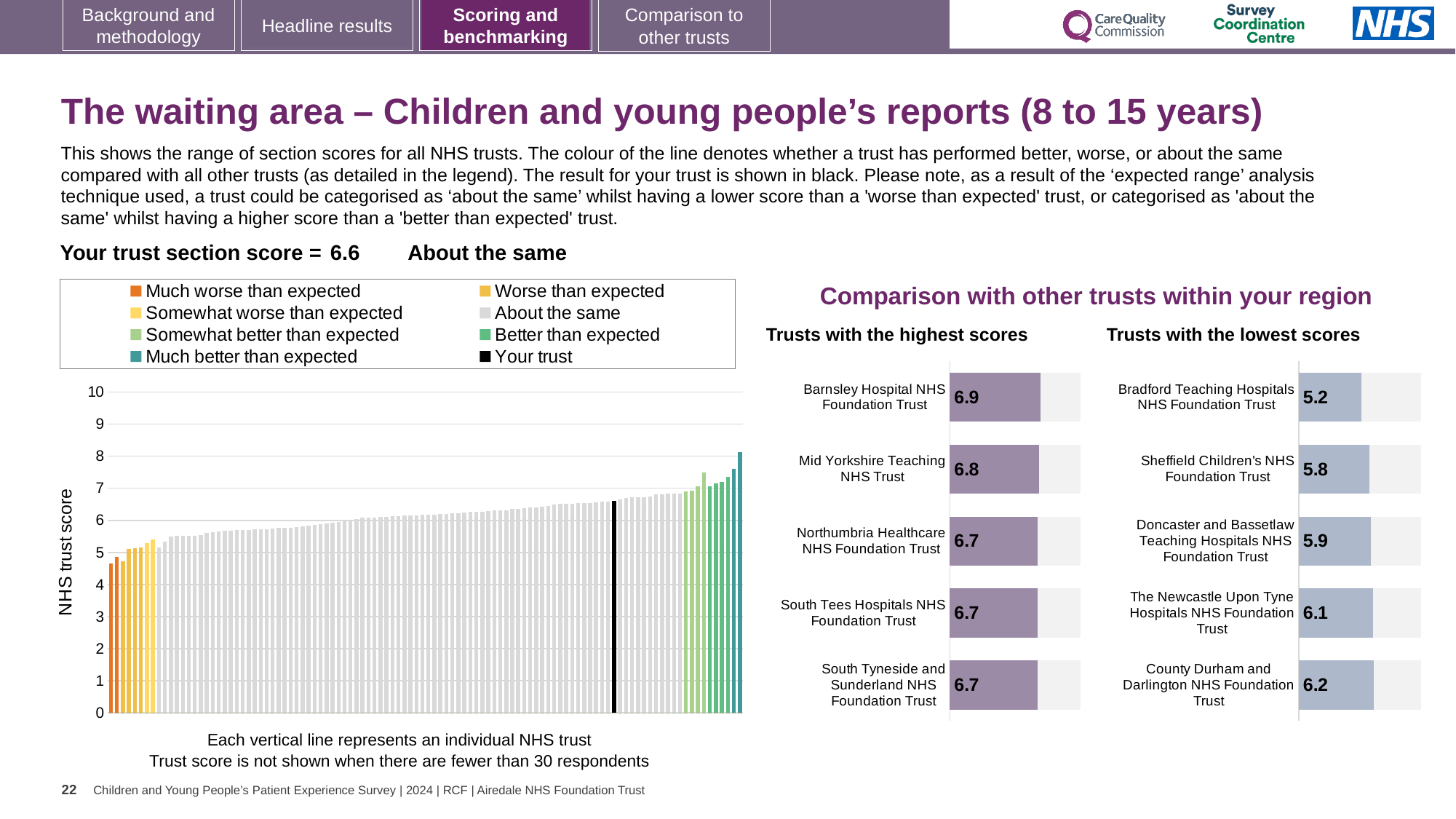
What kind of chart is the NHS trust score chart on the left? bar chart In the 'Trusts with the lowest scores' chart, which trust has the highest score? County Durham and Darlington NHS Foundation Trust In the 'Trusts with the lowest scores' chart, what is the difference between the scores of County Durham and Darlington NHS Foundation Trust and Bradford Teaching Hospitals NHS Foundation Trust? 1.0 How many entries does the legend of the NHS trust score chart on the left list? 8 In the 'Trusts with the highest scores' chart, what is the score for Barnsley Hospital NHS Foundation Trust? 6.9 In the NHS trust score chart on the left, do the bar values rise or fall from left to right? rise In the 'Trusts with the lowest scores' chart, which trust has the lowest score? Bradford Teaching Hospitals NHS Foundation Trust In the 'Trusts with the lowest scores' chart, what is the score for Bradford Teaching Hospitals NHS Foundation Trust? 5.2 In the 'Trusts with the lowest scores' chart, which has the larger score: Sheffield Children's NHS Foundation Trust or Doncaster and Bassetlaw Teaching Hospitals NHS Foundation Trust? Doncaster and Bassetlaw Teaching Hospitals NHS Foundation Trust In the 'Trusts with the highest scores' chart, how many trusts are shown? 5 In the 'Trusts with the highest scores' chart, what is the difference between the scores of Barnsley Hospital NHS Foundation Trust and Mid Yorkshire Teaching NHS Trust? 0.1 In the NHS trust score chart on the left, is the value for 'Your trust' (the black bar) greater or less than 6? greater